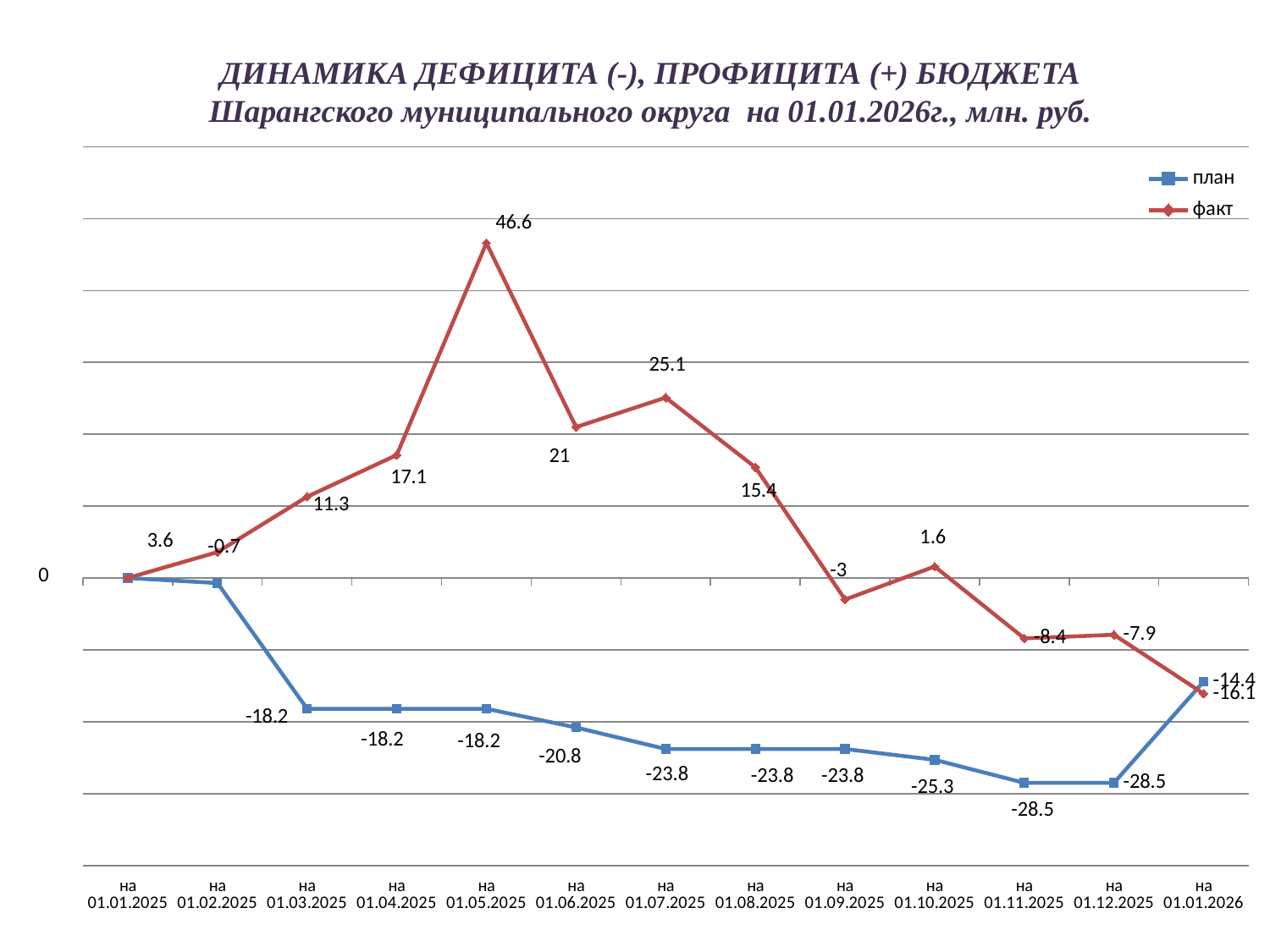
What is the difference between the факт values at 01.05.2025 and 01.06.2025? 25.6 Which colour is used for the факт series? red At which date does the факт series reach its highest value? 01.05.2025 What is the value of the факт series at 01.01.2026? -16.1 What type of chart is shown on the slide? line chart At 01.01.2026, which series has the larger value, план or факт? план What is the value of the факт series at 01.05.2025? 46.6 What is the value of the план series at 01.11.2025? -28.5 How many series does the legend list? 2 At which date does the факт series reach its lowest value? 01.01.2026 How many dates are shown along the x axis? 13 Does the план series rise or fall from 01.03.2025 to 01.11.2025? fall